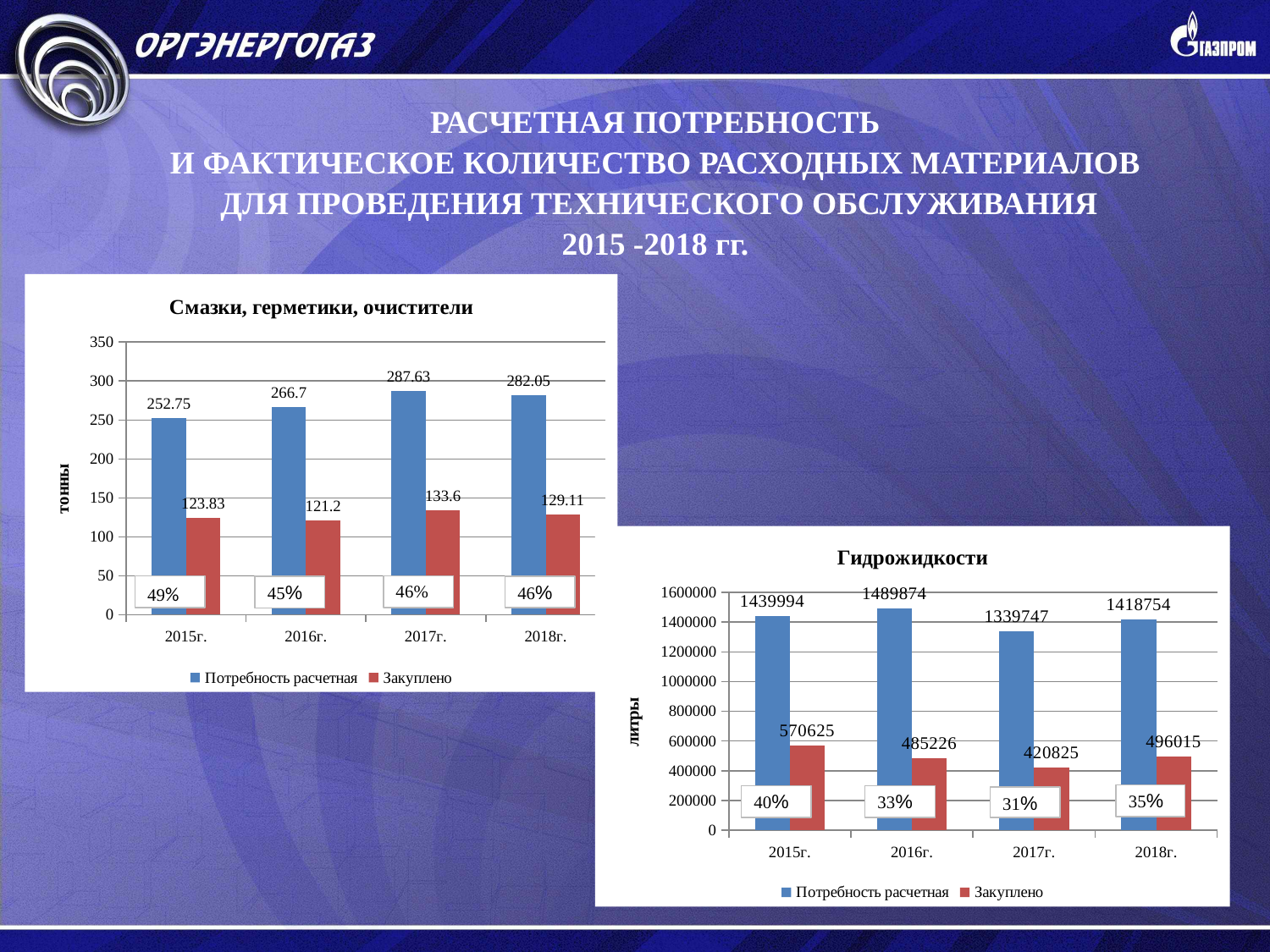
In the chart titled "Смазки, герметики, очистители", which year has the highest "Потребность расчетная" value? 2017г. In the chart titled "Гидрожидкости", what is the label on the vertical axis? литры In the chart titled "Гидрожидкости", what is the value of "Потребность расчетная" for 2016г.? 1489874 In the chart titled "Смазки, герметики, очистители", what is the value of "Потребность расчетная" for 2017г.? 287.63 In the chart titled "Гидрожидкости", what is the value of "Закуплено" for 2017г.? 420825 In the chart titled "Гидрожидкости", how many series does the legend list? 2 In the chart titled "Смазки, герметики, очистители", what percentage label is shown for 2015г.? 49% In the chart titled "Смазки, герметики, очистители", what is the value of "Закуплено" for 2016г.? 121.2 In the chart titled "Гидрожидкости", is the "Закуплено" value for 2015г. larger or smaller than the "Закуплено" value for 2018г.? larger What type of chart is the chart titled "Смазки, герметики, очистители"? bar chart In the chart titled "Гидрожидкости", which year has the lowest "Закуплено" value? 2017г. In the chart titled "Смазки, герметики, очистители", what is the difference between "Потребность расчетная" and "Закуплено" for 2015г.? 128.92